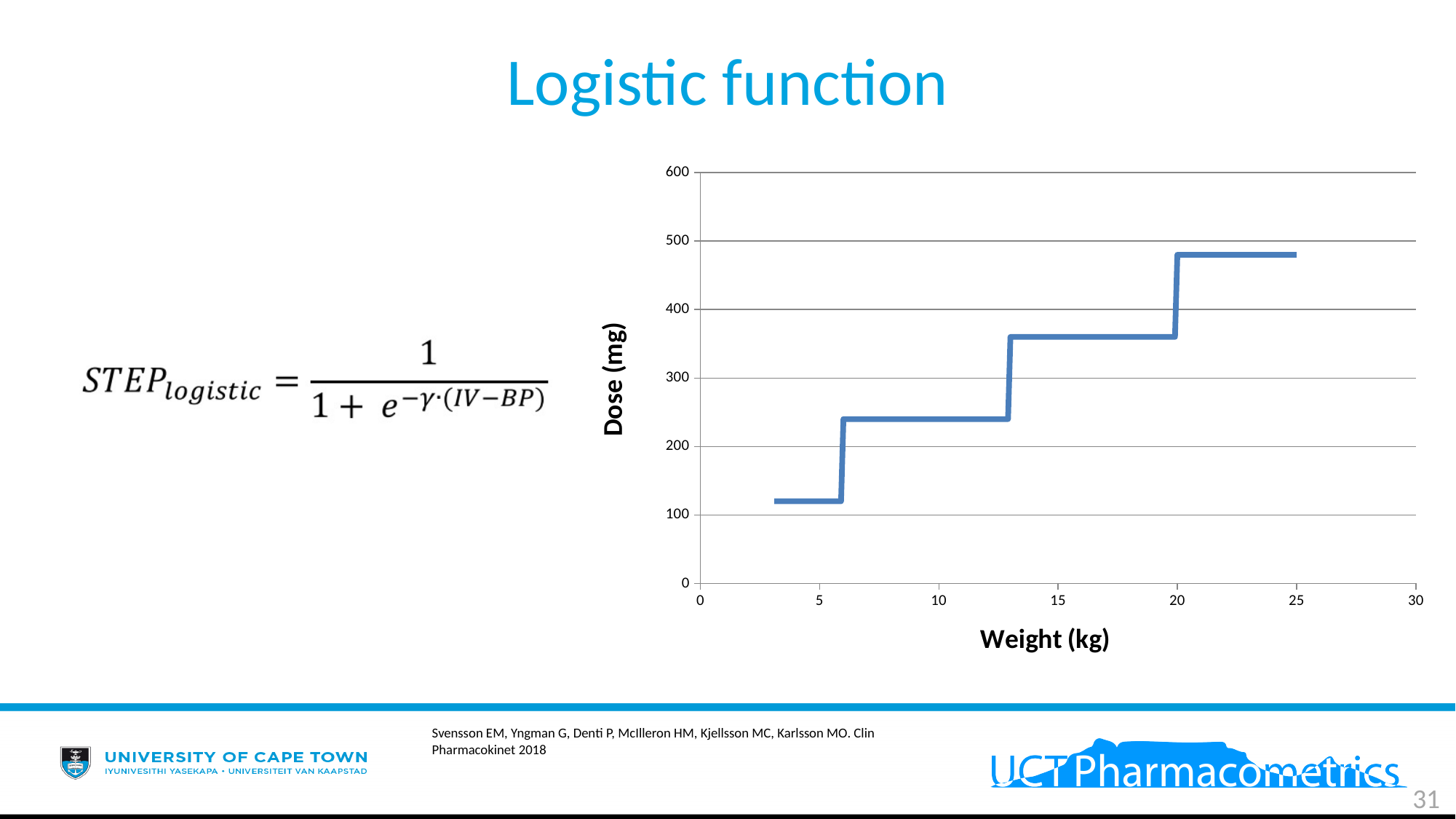
What is the label of the x axis? Weight (kg) What is the label of the y axis? Dose (mg) How many distinct dose levels (plateaus) does the step line show? 4 Is the dose at a weight of 10 kg greater or less than 300 mg? less Is the dose at a weight of 15 kg greater or less than 300 mg? greater Does the dose rise or fall as weight increases along the x axis? rise Is the dose at a weight of 15 kg greater or less than 400 mg? less What kind of chart is shown on the slide? line chart Which weight has the larger dose, 8 kg or 22 kg? 22 kg